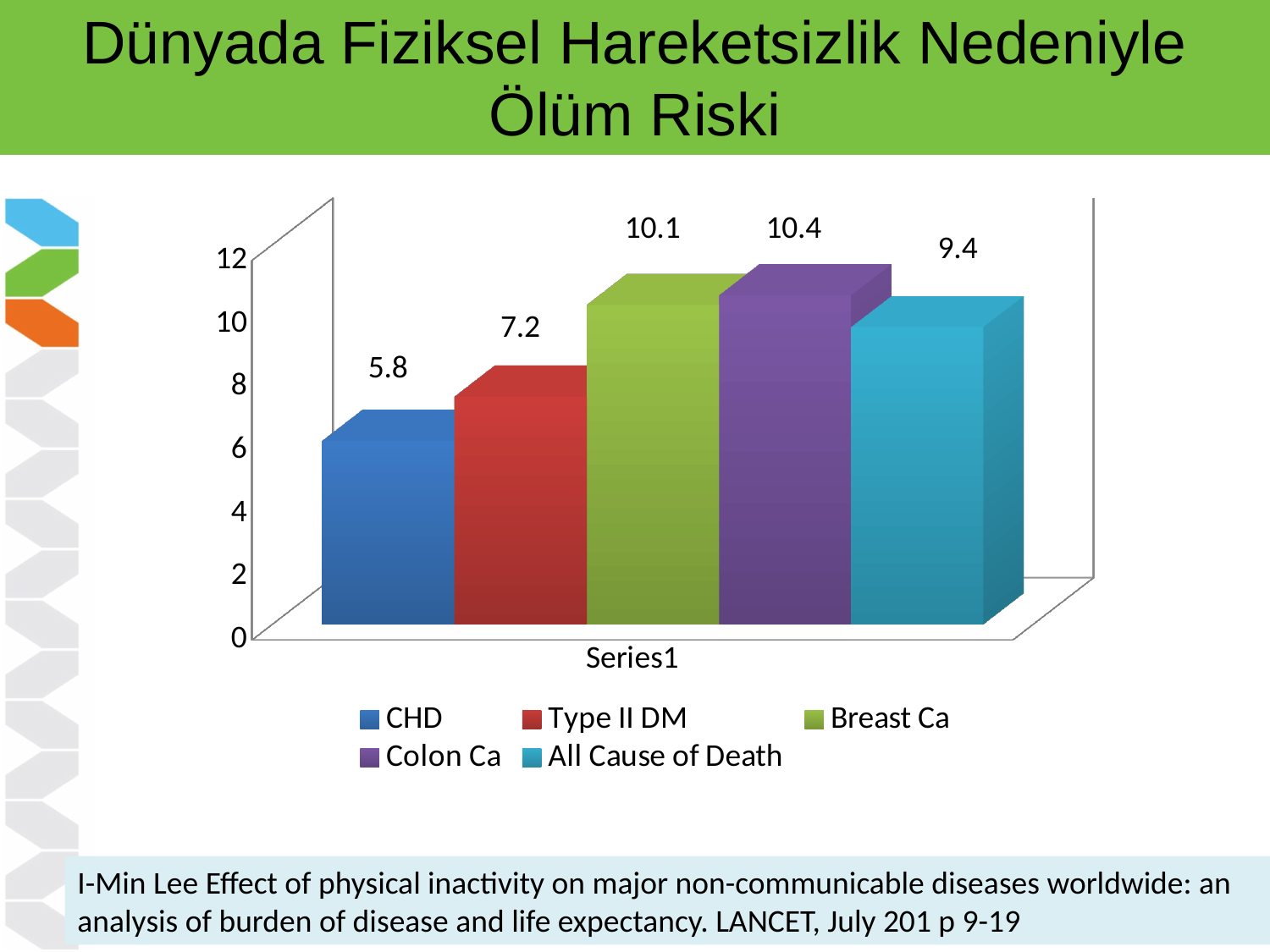
What is the value for Type II DM? 7.2 What is the difference between the values for Colon Ca and CHD? 4.6 What is the value for All Cause of Death? 9.4 What kind of chart is shown on the slide? Bar chart What colour is the bar for Colon Ca? Purple What is the value for CHD? 5.8 Which category has the lowest value? CHD How many bars are shown in the chart? 5 What is the value for Breast Ca? 10.1 How many entries does the legend list? 5 Which is larger, the value for Type II DM or the value for All Cause of Death? All Cause of Death Which category has the highest value? Colon Ca